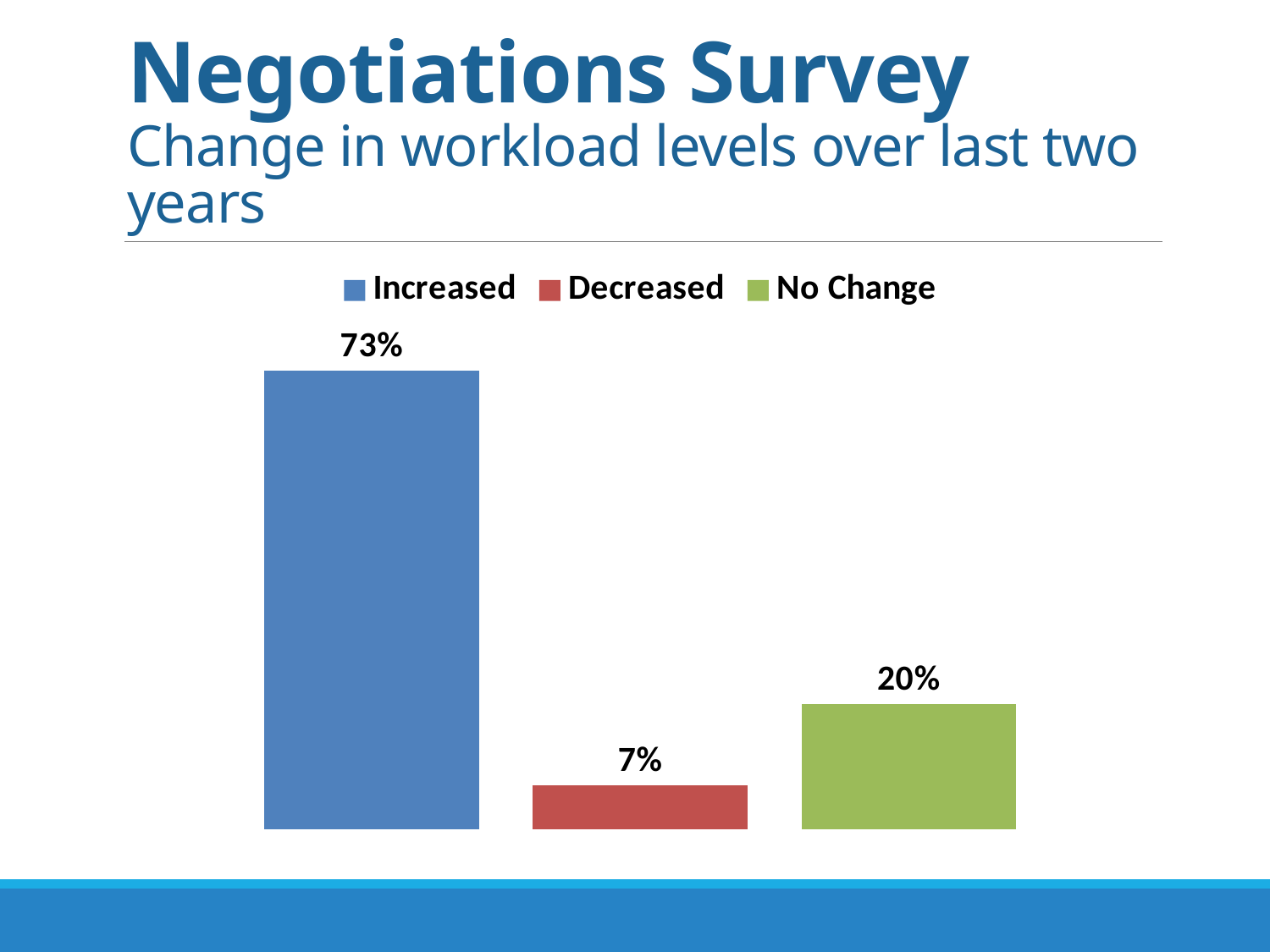
What percentage of respondents reported that their workload Increased? 73% What kind of chart is shown on the slide? Bar chart What is the difference in percentage points between Increased and No Change? 53 What is the total of the three percentages shown? 100% Which response has the lowest percentage? Decreased Which is larger, the percentage for Decreased or for No Change? No Change Which response has the highest percentage? Increased What percentage of respondents reported that their workload Decreased? 7% What is the difference in percentage points between No Change and Decreased? 13 What percentage of respondents reported No Change in workload? 20% What colour is the bar for Decreased? Red How many series does the legend list? 3